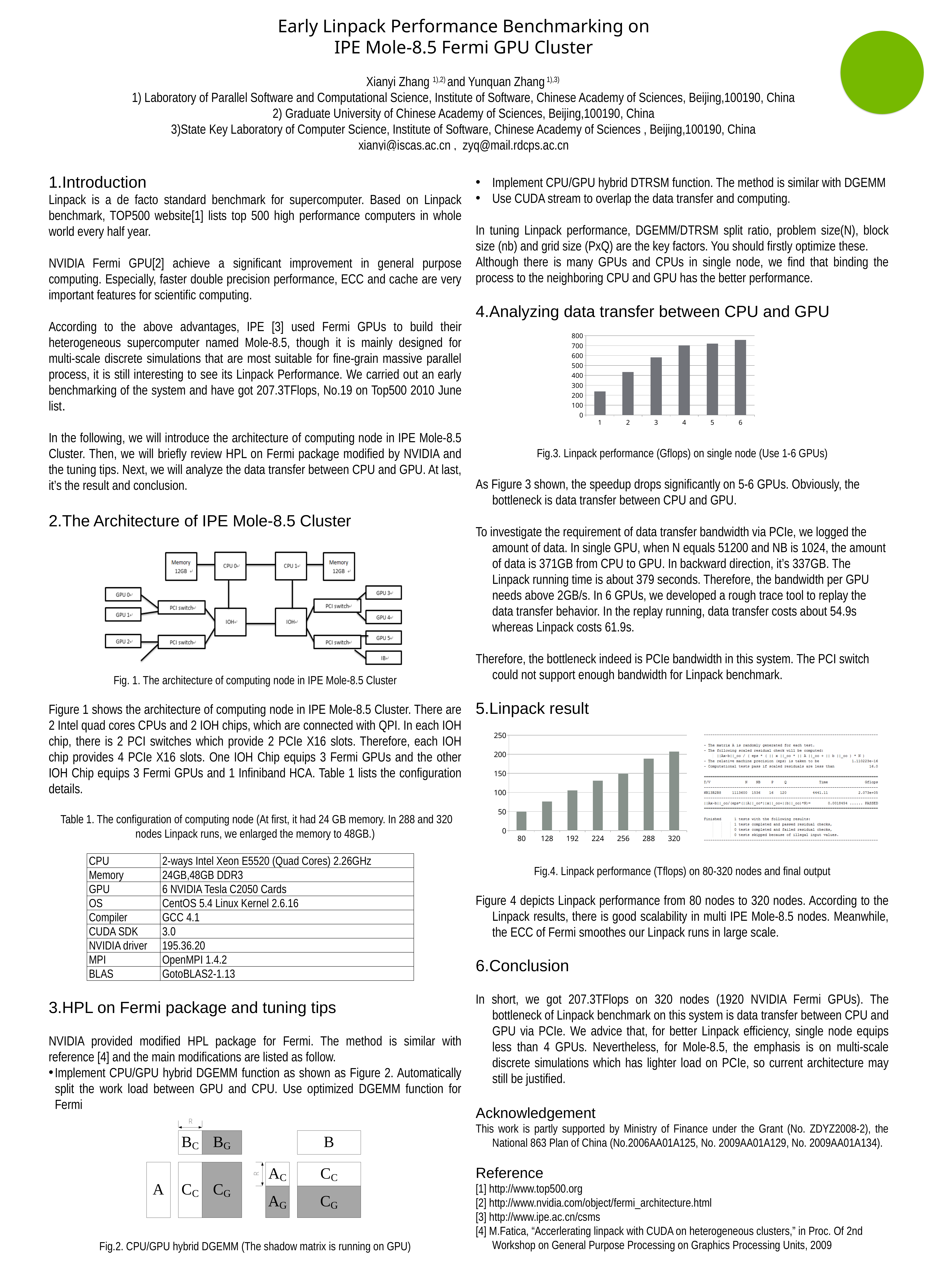
In Fig.3 (Linpack performance on single node), what kind of chart is shown? bar chart In Fig.3 (Linpack performance on single node), how many GPU counts are plotted on the x axis? 6 In Fig.4 (Linpack performance on 80-320 nodes), which is larger, the value for 192 nodes or for 256 nodes? 256 In Fig.3 (Linpack performance on single node), which number of GPUs has the lowest bar? 1 In Fig.4 (Linpack performance on 80-320 nodes), how many node counts are plotted on the x axis? 7 In Fig.4 (Linpack performance on 80-320 nodes), which node count has the lowest bar? 80 In Fig.3 (Linpack performance on single node), is the value for 3 GPUs greater or less than 500? greater In Fig.3 (Linpack performance on single node), do the values rise or fall as the number of GPUs increases from 1 to 6? rise In Fig.4 (Linpack performance on 80-320 nodes), is the value for 288 nodes greater or less than 150? greater In Fig.4 (Linpack performance on 80-320 nodes), which node count has the highest bar? 320 In Fig.3 (Linpack performance on single node), which number of GPUs has the highest bar? 6 In Fig.3 (Linpack performance on single node), is the value for 1 GPU greater or less than 300? less